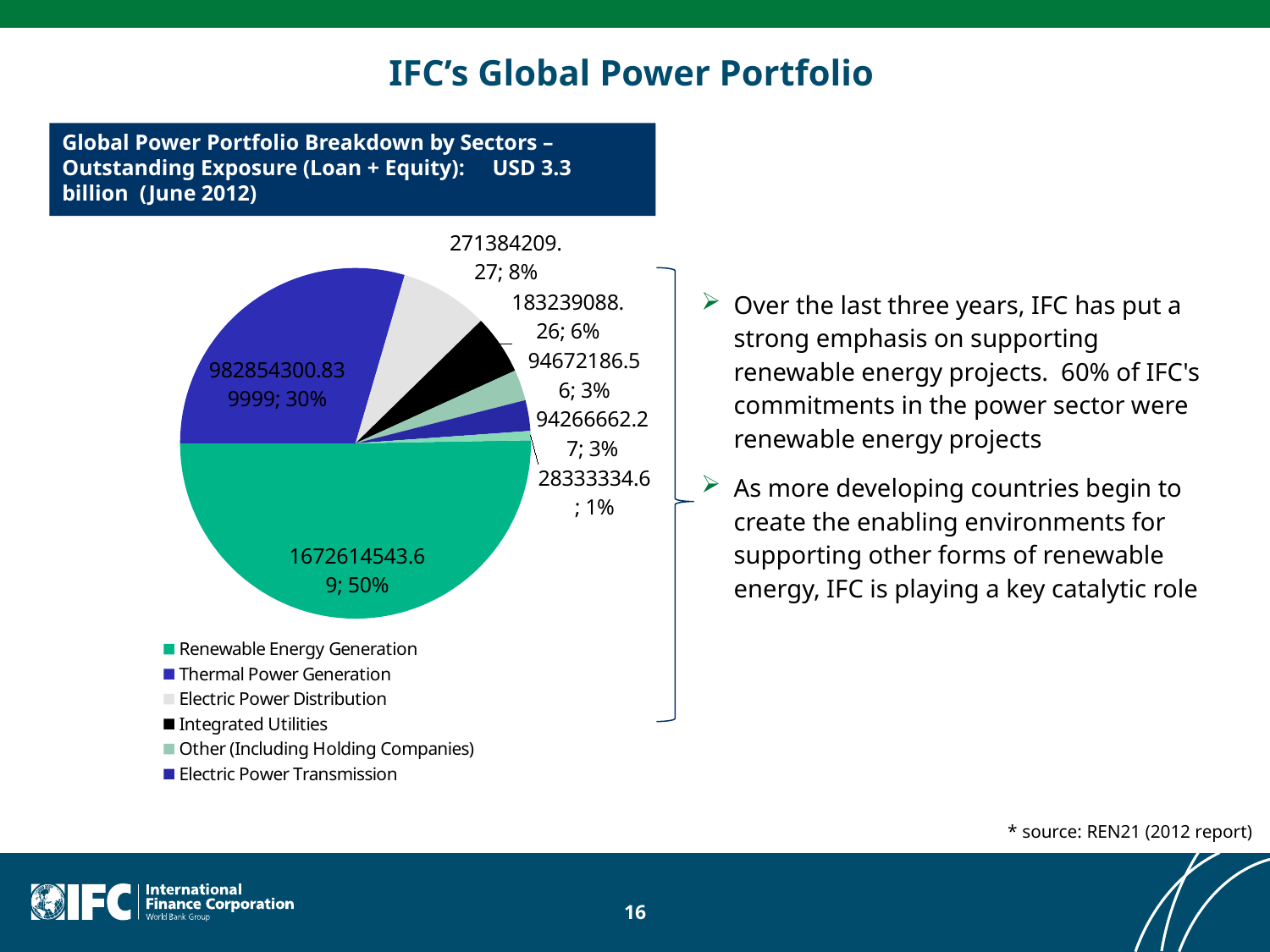
What share of the pie does Electric Power Distribution account for? 8% Which is larger, the slice for Renewable Energy Generation or the slice for Thermal Power Generation? Renewable Energy Generation What is the title of the chart? Global Power Portfolio Breakdown by Sectors – Outstanding Exposure (Loan + Equity): USD 3.3 billion (June 2012) By how many percentage points does the Renewable Energy Generation share exceed the Thermal Power Generation share? 20% What kind of chart is shown on the slide? pie chart What share of the pie does Thermal Power Generation account for? 30% What colour is the Renewable Energy Generation slice? green What is the value printed for the Renewable Energy Generation slice? 1672614543.69 Which sector has the largest slice of the pie? Renewable Energy Generation What share of the pie does Integrated Utilities account for? 6% How many entries does the legend list? 6